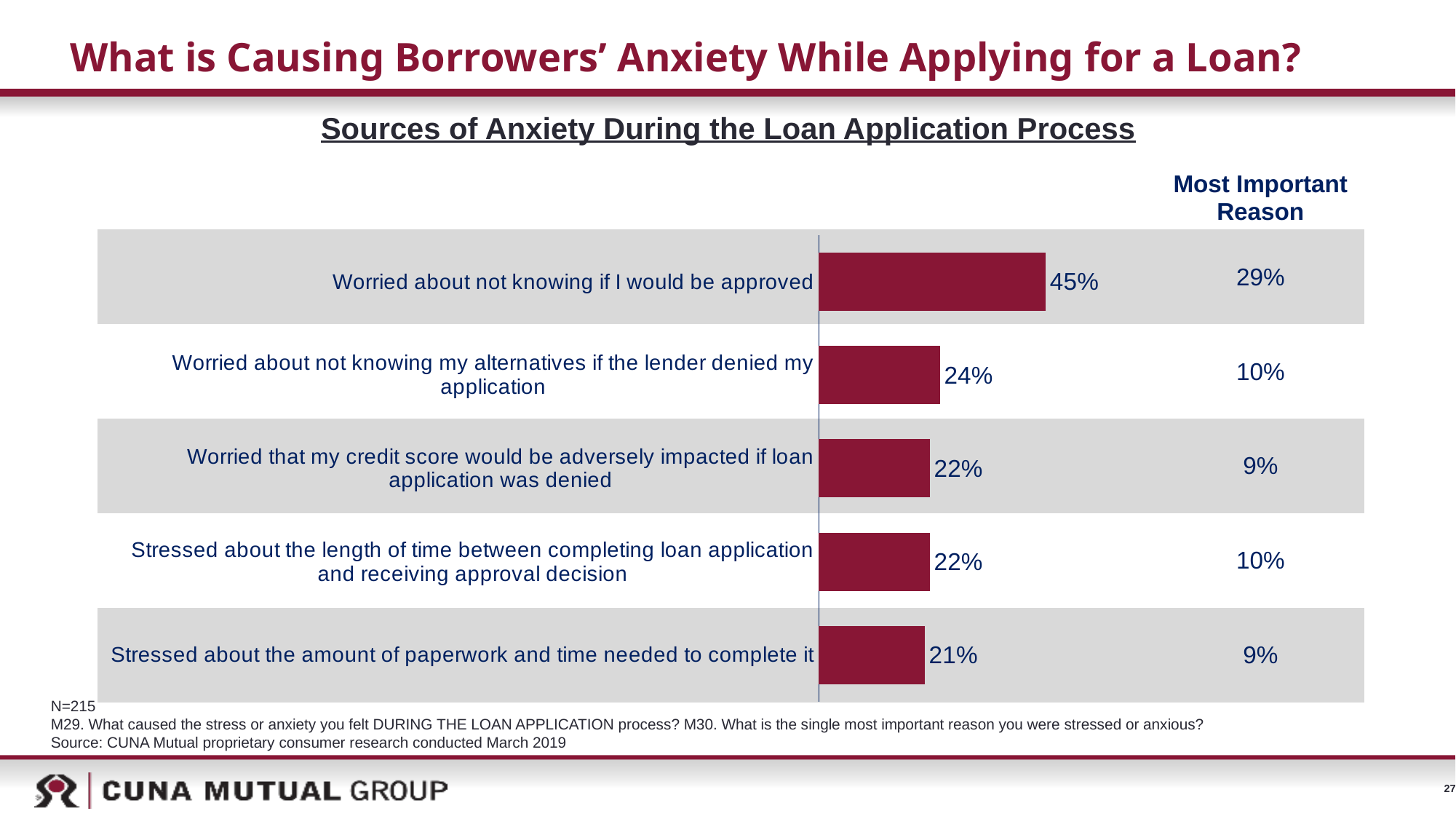
Which is larger: the percentage for 'Worried about not knowing my alternatives if the lender denied my application' or for 'Stressed about the amount of paperwork and time needed to complete it'? Worried about not knowing my alternatives if the lender denied my application What is the title of the chart? Sources of Anxiety During the Loan Application Process What type of chart is used to show the sources of anxiety? Bar chart What percentage of borrowers were worried about not knowing if they would be approved? 45% In the 'Most Important Reason' column, what percentage is shown for 'Stressed about the length of time between completing loan application and receiving approval decision'? 10% How many sources of anxiety are listed in the bar chart? 5 What percentage of borrowers were worried about not knowing their alternatives if the lender denied their application? 24% In the 'Most Important Reason' column, what percentage is shown for 'Worried about not knowing if I would be approved'? 29% What is the difference between the percentage for 'Worried about not knowing if I would be approved' and the percentage for 'Worried about not knowing my alternatives if the lender denied my application'? 21 percentage points Which source of anxiety has the lowest percentage in the bar chart? Stressed about the amount of paperwork and time needed to complete it Which source of anxiety has the highest percentage in the bar chart? Worried about not knowing if I would be approved What percentage of borrowers were stressed about the amount of paperwork and time needed to complete it? 21%